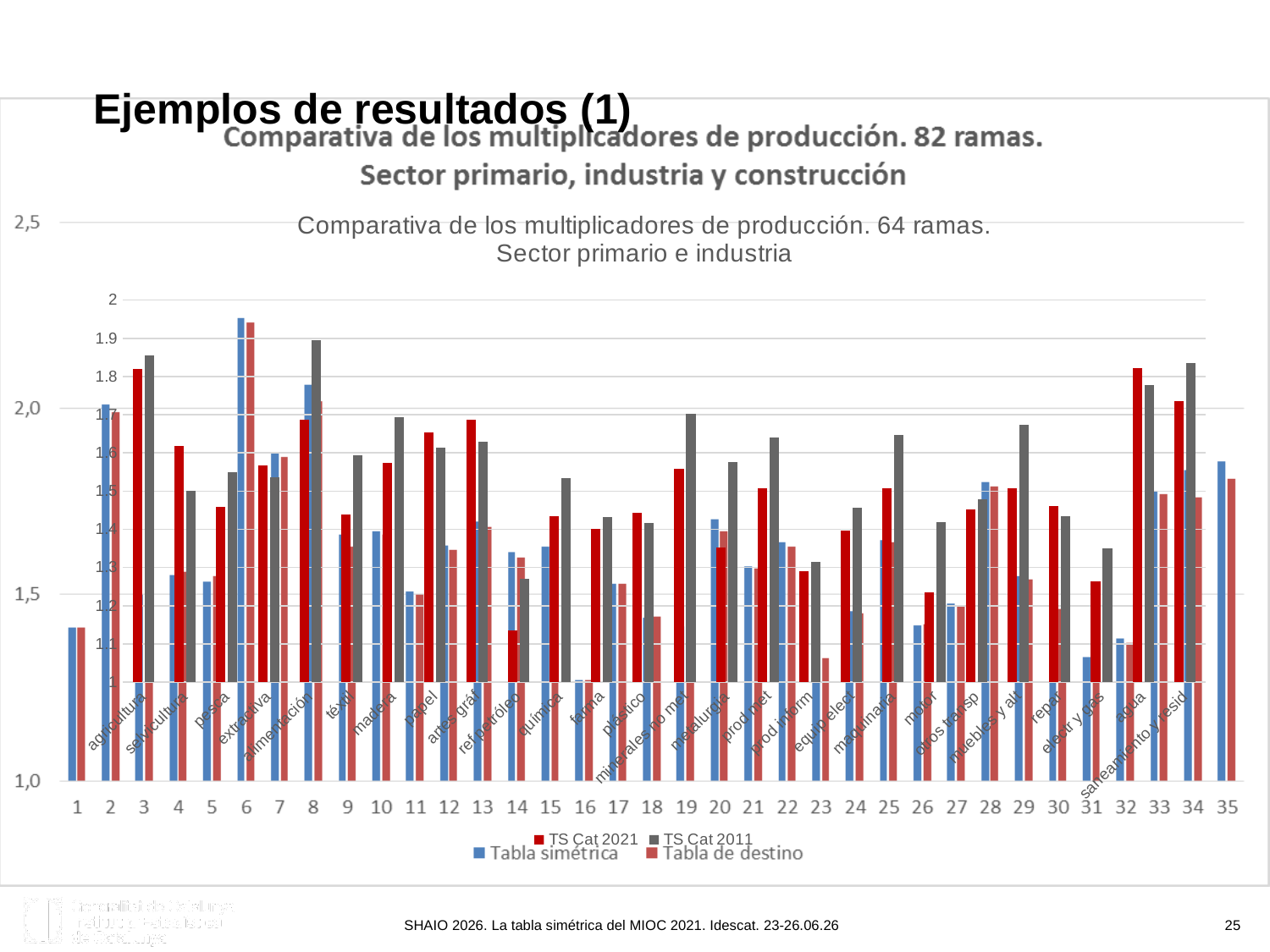
In the chart titled 'Comparativa de los multiplicadores de producción. 82 ramas. Sector primario, industria y construcción', how many series does the legend list? 2 In the chart titled 'Comparativa de los multiplicadores de producción. 82 ramas. Sector primario, industria y construcción', what are the two legend entries? Tabla simétrica and Tabla de destino In the chart titled 'Comparativa de los multiplicadores de producción. 64 ramas. Sector primario e industria', how many series does the legend list? 2 What kind of chart is the background chart titled 'Comparativa de los multiplicadores de producción. 82 ramas. Sector primario, industria y construcción'? bar chart In the chart titled 'Comparativa de los multiplicadores de producción. 82 ramas. Sector primario, industria y construcción', is the Tabla simétrica value for category 35 greater or less than 1,5? greater In the chart titled 'Comparativa de los multiplicadores de producción. 82 ramas. Sector primario, industria y construcción', is the Tabla simétrica value for category 1 greater or less than 1,5? less In the chart titled 'Comparativa de los multiplicadores de producción. 82 ramas. Sector primario, industria y construcción', how many numbered categories are on the x axis? 35 In the chart titled 'Comparativa de los multiplicadores de producción. 82 ramas. Sector primario, industria y construcción', is the Tabla simétrica value for category 6 greater or less than 2,0? greater In the chart titled 'Comparativa de los multiplicadores de producción. 64 ramas. Sector primario e industria', what are the two legend entries? TS Cat 2021 and TS Cat 2011 What kind of chart is the foreground chart titled 'Comparativa de los multiplicadores de producción. 64 ramas. Sector primario e industria'? bar chart